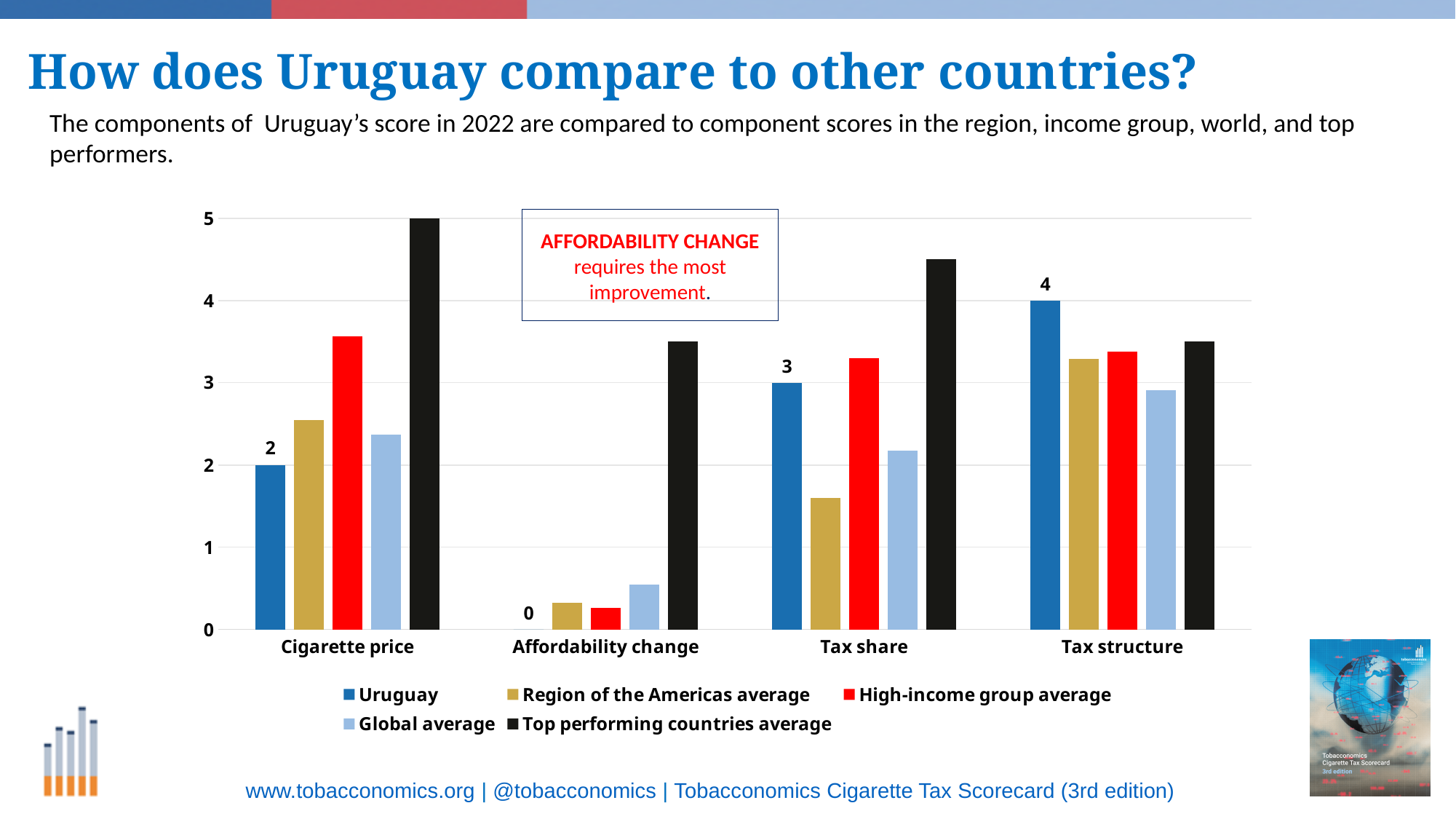
What is Uruguay's score for Tax share? 3 What is Uruguay's score for Affordability change? 0 Is the Top performing countries average for Affordability change greater or less than 3? greater How many series does the legend list? 5 What is Uruguay's score for Cigarette price? 2 Is the Region of the Americas average for Tax share greater or less than 2? less For Cigarette price, which is larger: Uruguay's score or the Top performing countries average? Top performing countries average What kind of chart is shown on the slide? Bar chart In which component does Uruguay have its lowest score? Affordability change What is the difference between Uruguay's Tax structure score and its Cigarette price score? 2 In which component does Uruguay have its highest score? Tax structure What is Uruguay's score for Tax structure? 4